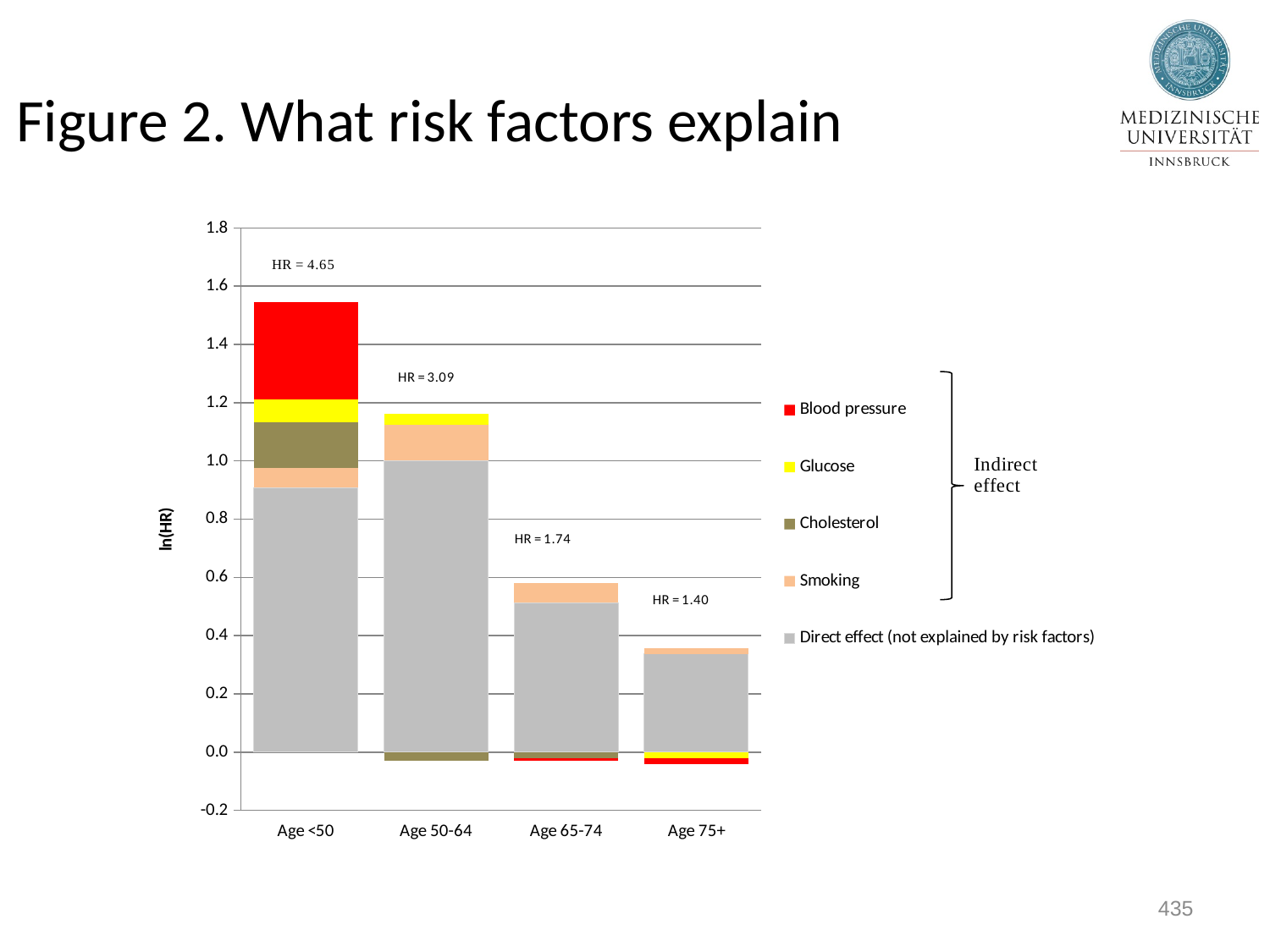
Which has a larger HR value, Age 50-64 or Age 75+? Age 50-64 What kind of chart is shown on the slide? Stacked bar chart What is the difference between the HR values for Age <50 and Age 50-64? 1.56 Which age group has the lowest HR value? Age 75+ Do the HR values rise or fall as age increases along the x axis? Fall Which age group has the highest HR value? Age <50 How many age groups are shown on the x axis? 4 What HR value is printed above the Age <50 bar? HR = 4.65 What is the label on the y axis? ln(HR) How many series does the legend list? 5 What HR value is printed above the Age 65-74 bar? HR = 1.74 Is the Direct effect value for Age 75+ greater or less than 0.4? less